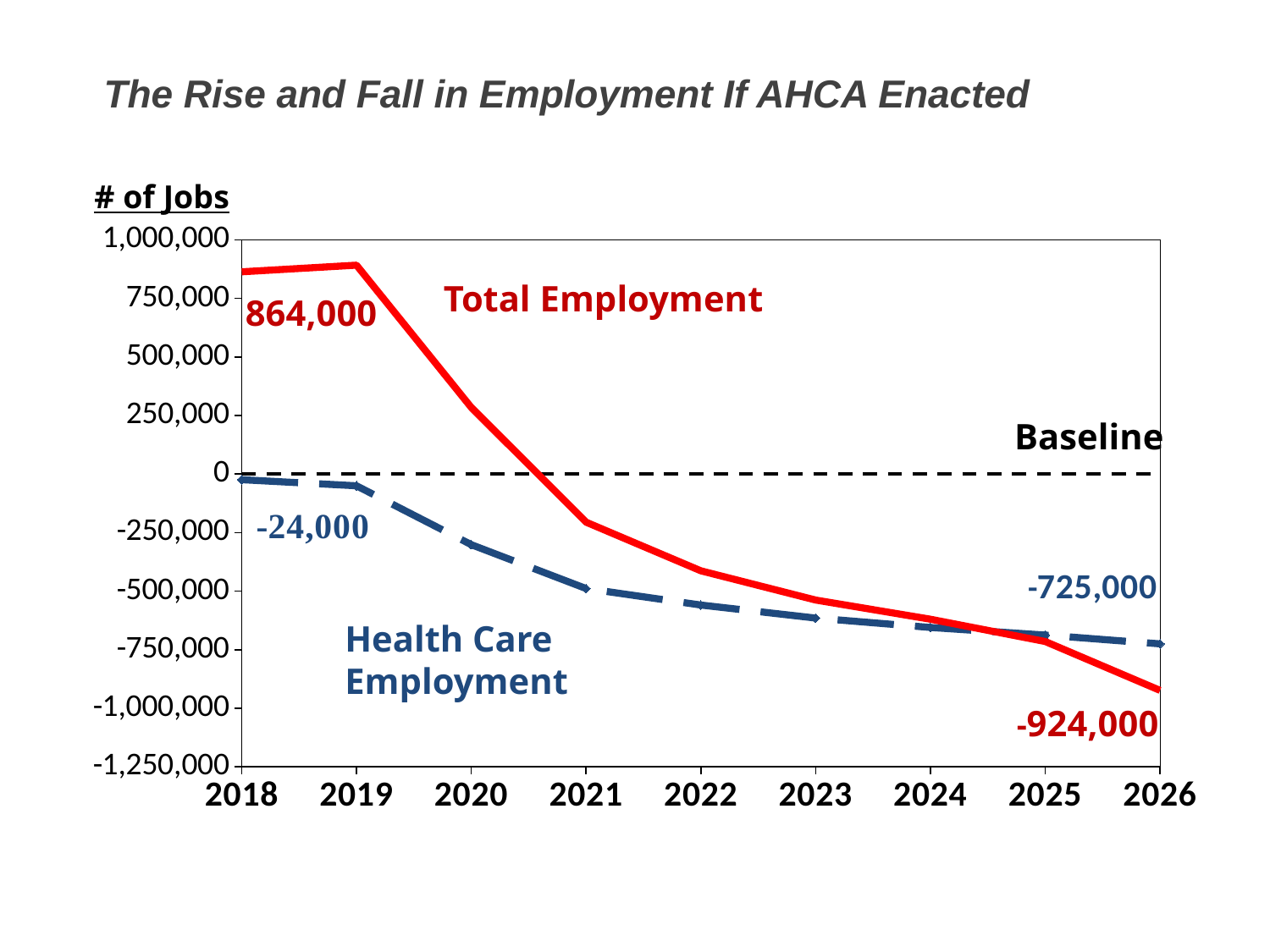
Does Total Employment rise or fall from 2019 to 2026? Fall Is the value for Total Employment in 2021 greater or less than 0? less What is the value of Total Employment in 2026? -924,000 What kind of chart is shown on the slide? Line chart In 2026, which series has the lower value, Total Employment or Health Care Employment? Total Employment What is the value of Health Care Employment in 2018? -24,000 By how much does Total Employment change from 2018 to 2026? 1,788,000 decrease Is the value for Total Employment in 2020 greater or less than 250,000? greater What is the difference between Health Care Employment and Total Employment in 2026? 199,000 What is the value of Total Employment in 2018? 864,000 How many years are shown on the x axis? 9 What is the value of Health Care Employment in 2026? -725,000